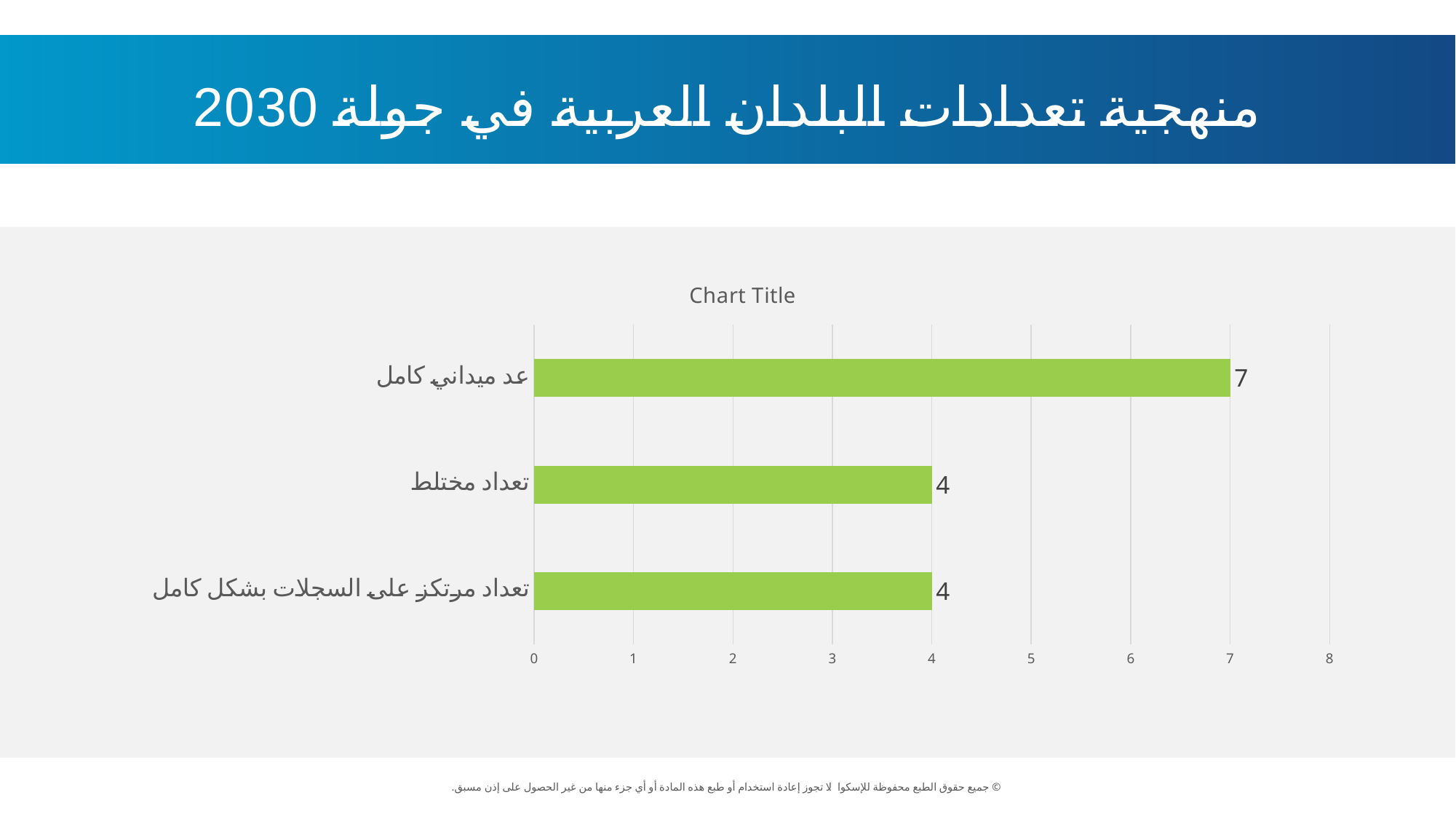
What is the value for عد ميداني كامل? 7 Which category has the highest value? عد ميداني كامل What is the value for تعداد مرتكز على السجلات بشكل كامل? 4 What is the value for تعداد مختلط? 4 Which is larger, the value for عد ميداني كامل or the value for تعداد مرتكز على السجلات بشكل كامل? عد ميداني كامل Is the value for تعداد مختلط greater or less than 6? less Is the value for عد ميداني كامل greater or less than 5? greater How many categories are shown in the chart? 3 What is the difference between the values for عد ميداني كامل and تعداد مختلط? 3 What is the title shown above the chart? Chart Title What is the maximum value shown on the horizontal axis? 8 What kind of chart is shown on the slide? bar chart